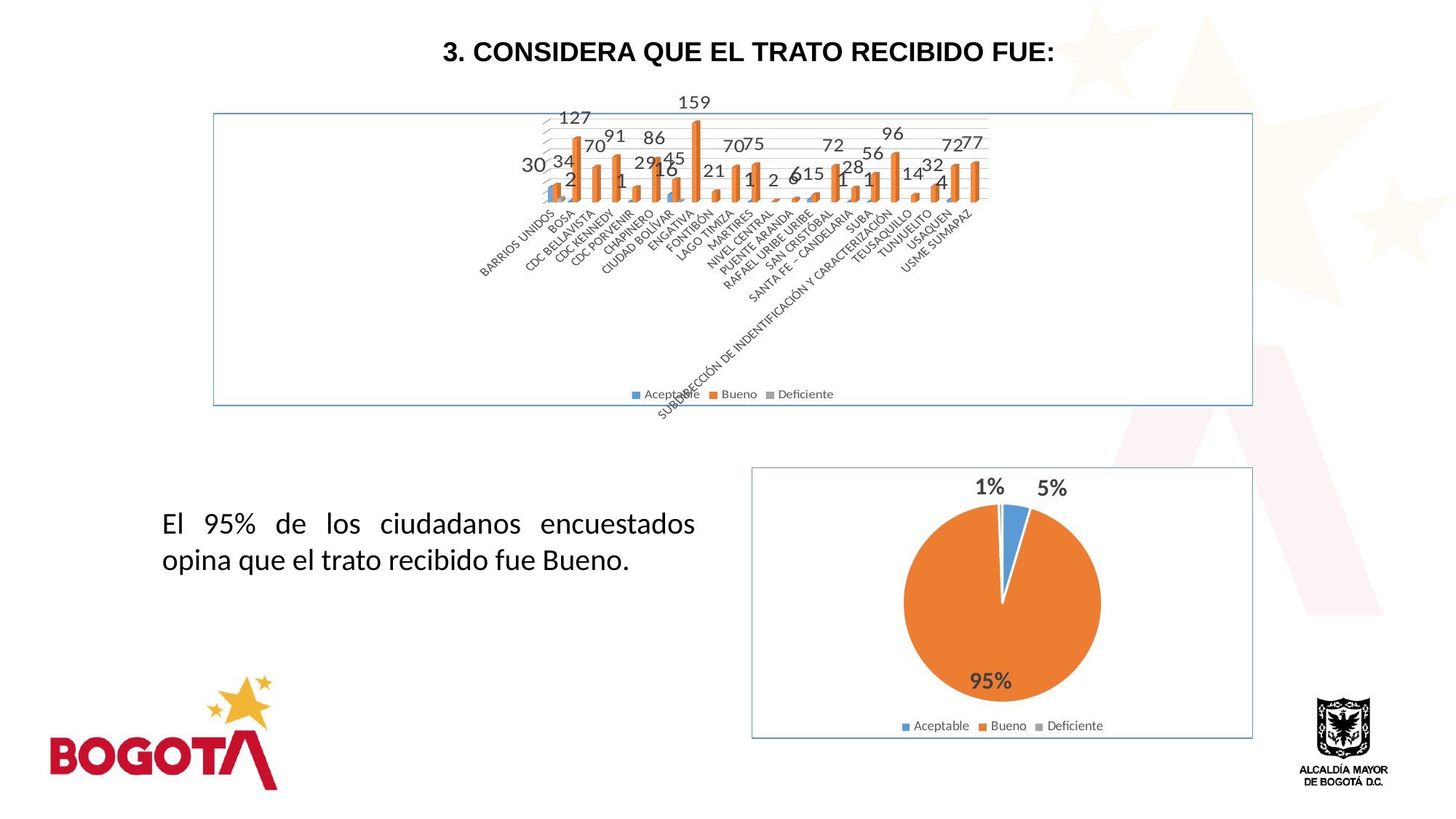
In the pie chart, which category has the largest slice? Bueno What are the three legend entries of the top bar chart? Aceptable, Bueno, Deficiente In the top bar chart, which category has the tallest bar? ENGATIVA How many series does the legend of the pie chart list? 3 In the pie chart, which slice is larger, Aceptable or Deficiente? Aceptable In the top bar chart, what is the highest value shown by a data label? 159 In the pie chart, which category has the smallest slice? Deficiente What kind of chart is the chart at the bottom right of the slide? pie chart In the pie chart, what share of respondents said the treatment was Deficiente? 1% In the pie chart, what share of respondents said the treatment was Bueno? 95% What kind of chart is the chart at the top of the slide? bar chart In the pie chart, what share of respondents said the treatment was Aceptable? 5%